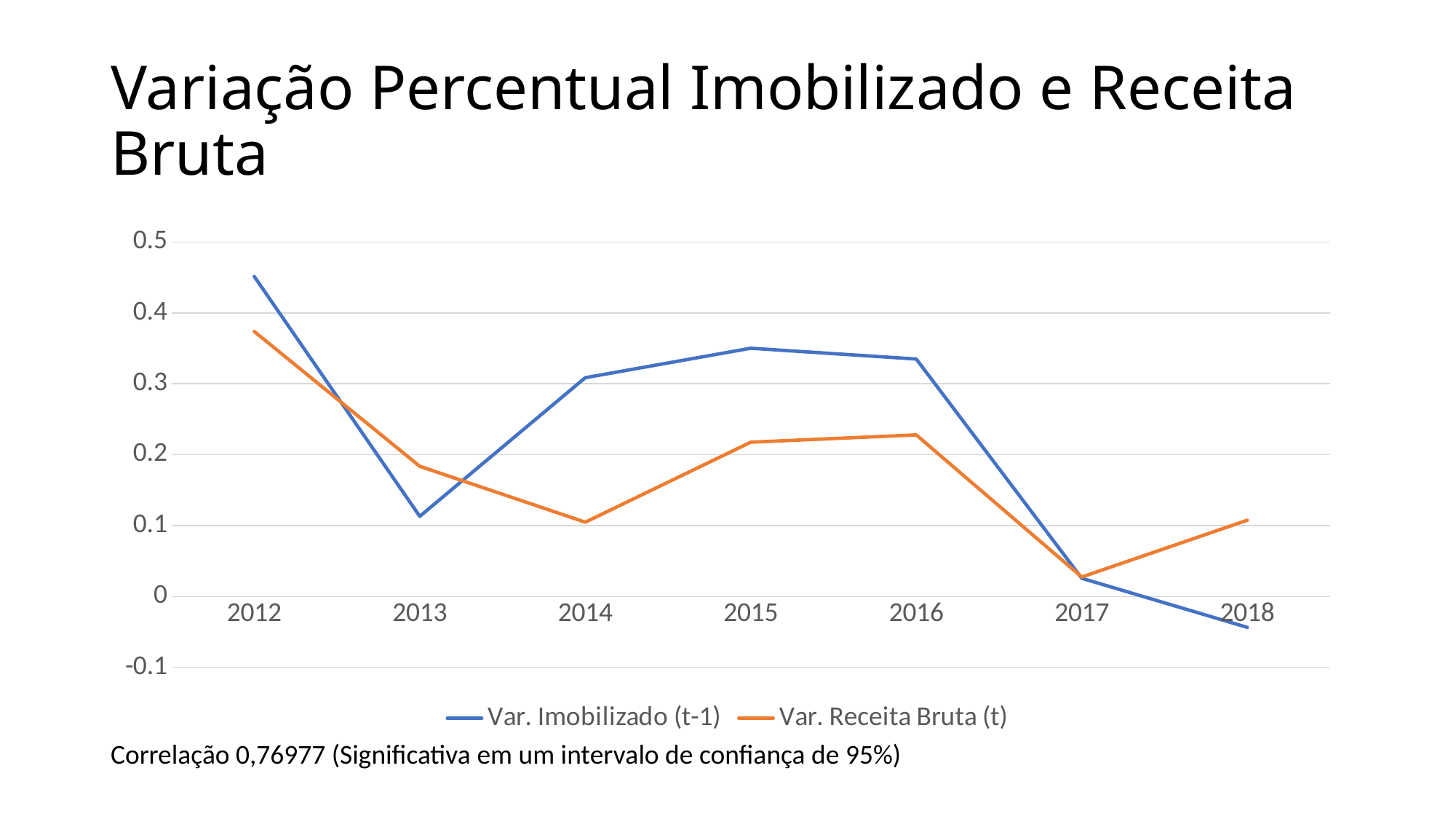
In which year does Var. Receita Bruta (t) reach its highest value? 2012 Does Var. Imobilizado (t-1) rise or fall from 2016 to 2018? fall Is the value for Var. Imobilizado (t-1) in 2012 greater or less than 0.4? greater In which year does Var. Imobilizado (t-1) reach its highest value? 2012 Is the value for Var. Receita Bruta (t) in 2014 greater or less than 0.2? less How many series does the legend list? 2 How many years are plotted along the x axis? 7 In which year does Var. Receita Bruta (t) reach its lowest value? 2017 In 2015, which series has the larger value, Var. Imobilizado (t-1) or Var. Receita Bruta (t)? Var. Imobilizado (t-1) In which year does Var. Imobilizado (t-1) reach its lowest value? 2018 In 2013, which series has the larger value, Var. Imobilizado (t-1) or Var. Receita Bruta (t)? Var. Receita Bruta (t) What kind of chart is shown on the slide? line chart